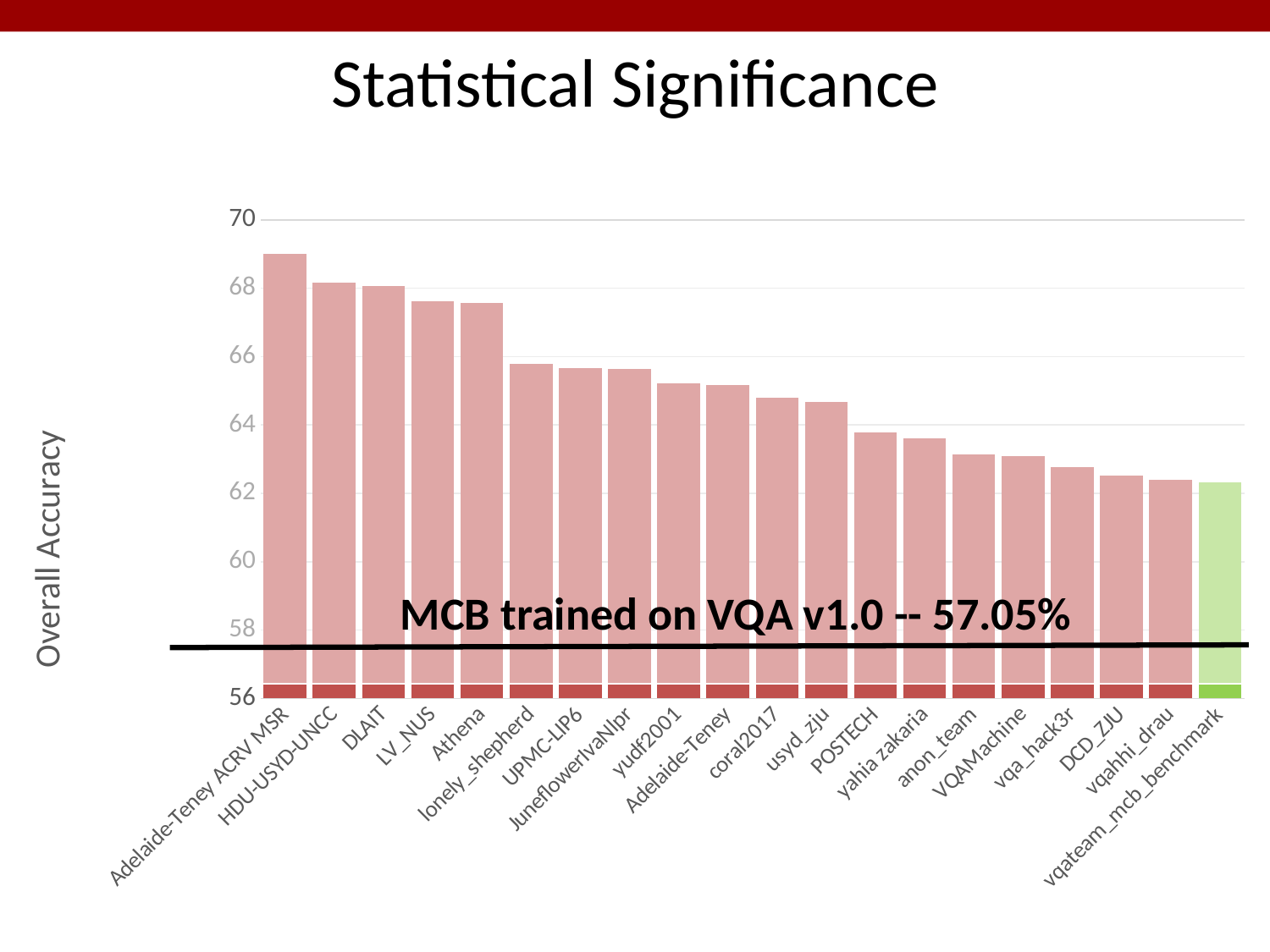
What is the title of the y axis? Overall Accuracy Which has a larger value, Athena or POSTECH? Athena Is the value for Adelaide-Teney ACRV MSR greater or less than 68? greater Is the value for coral2017 greater or less than 64? greater Is the value for vqateam_mcb_benchmark greater or less than 64? less Do the bar values rise or fall from left to right along the x axis? fall How many teams (bars) are plotted in the chart? 20 What accuracy does the horizontal reference line labelled 'MCB trained on VQA v1.0' mark? 57.05% Which team has the highest overall accuracy in the chart? Adelaide-Teney ACRV MSR What kind of chart is shown on the slide? bar chart